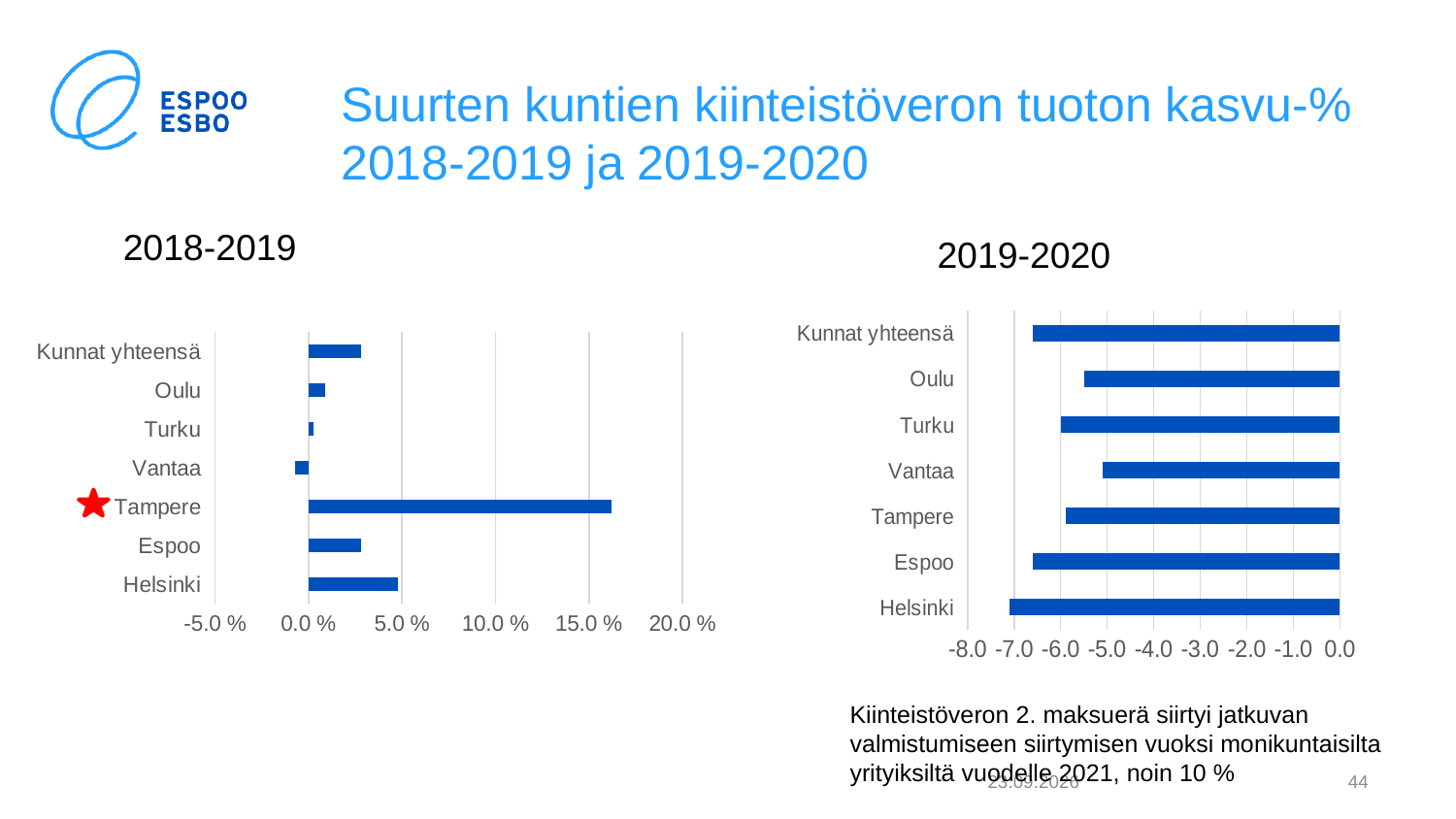
In the 2019-2020 chart, which category has the most negative value? Helsinki In the 2018-2019 chart, which is larger, the value for Helsinki or the value for Espoo? Helsinki In the 2018-2019 chart, is the value for Tampere greater or less than 15.0 %? greater In the 2018-2019 chart, is the value for Vantaa greater or less than 0.0 %? less What type of chart is the 2019-2020 chart? Bar chart In the 2019-2020 chart, which category has the highest (least negative) value? Vantaa In the 2019-2020 chart, is the value for Oulu greater or less than -6.0? greater In the 2019-2020 chart, which is larger, the value for Vantaa or the value for Helsinki? Vantaa In the 2018-2019 chart, which municipality has the lowest value? Vantaa How many municipalities/categories are shown in the 2018-2019 chart? 7 In the 2018-2019 chart, which municipality has the highest growth percentage? Tampere